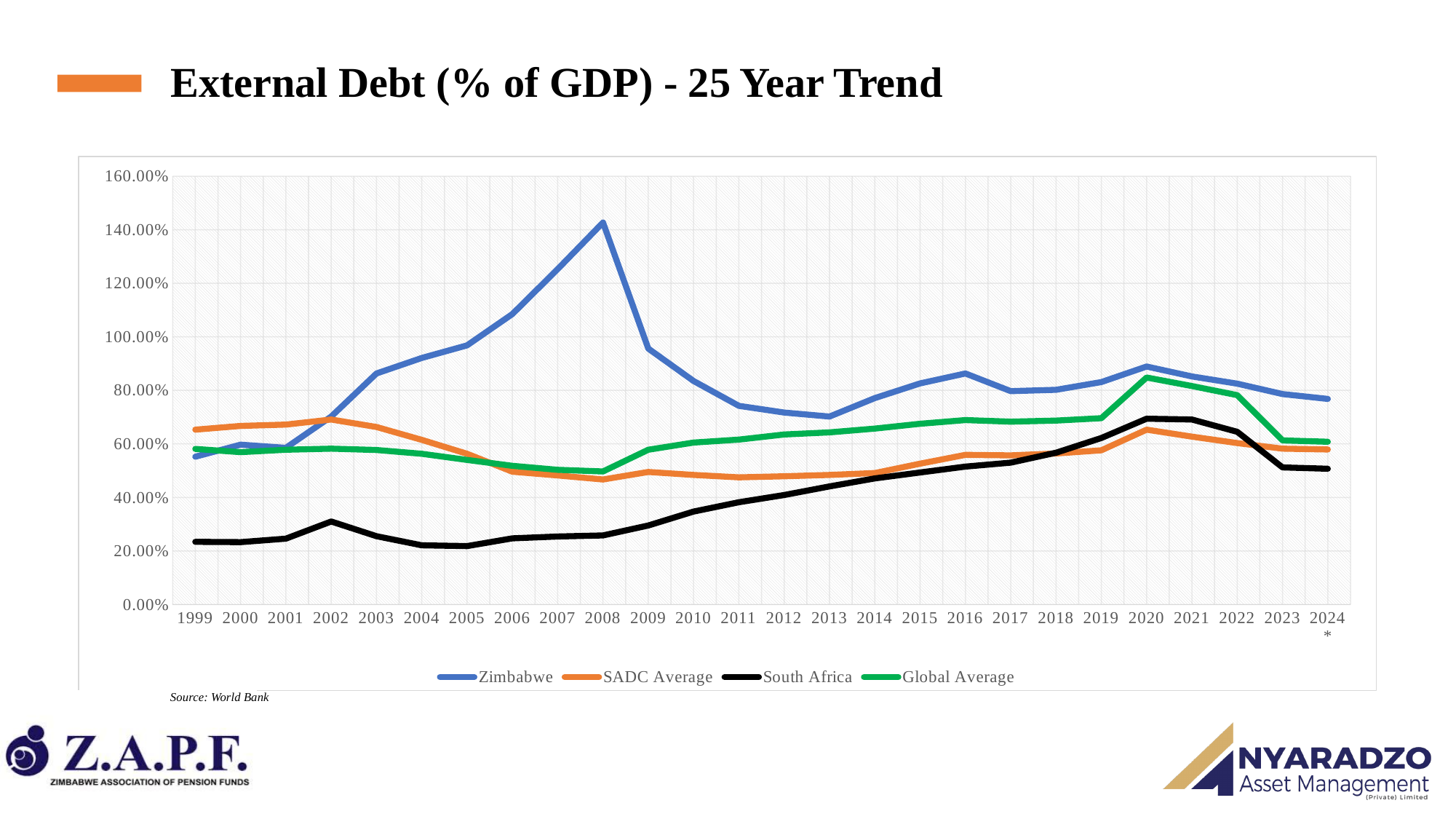
Which is larger in 2008, the value for Zimbabwe or the value for South Africa? Zimbabwe What is the title of the chart? External Debt (% of GDP) - 25 Year Trend How many years are plotted along the x axis? 26 Is the value for Global Average in 2020 greater or less than 80.00%? greater Is the value for South Africa in 1999 greater or less than 40.00%? less In which year does the Zimbabwe line reach its highest value? 2008 What kind of chart is shown on the slide? Line chart Which series has the lowest value in 2010? South Africa Does the South Africa line rise or fall between 2005 and 2020? Rise How many series does the legend list? 4 Is the value for Zimbabwe in 2008 greater or less than 120.00%? greater Which is larger in 2020, the value for Global Average or the value for SADC Average? Global Average